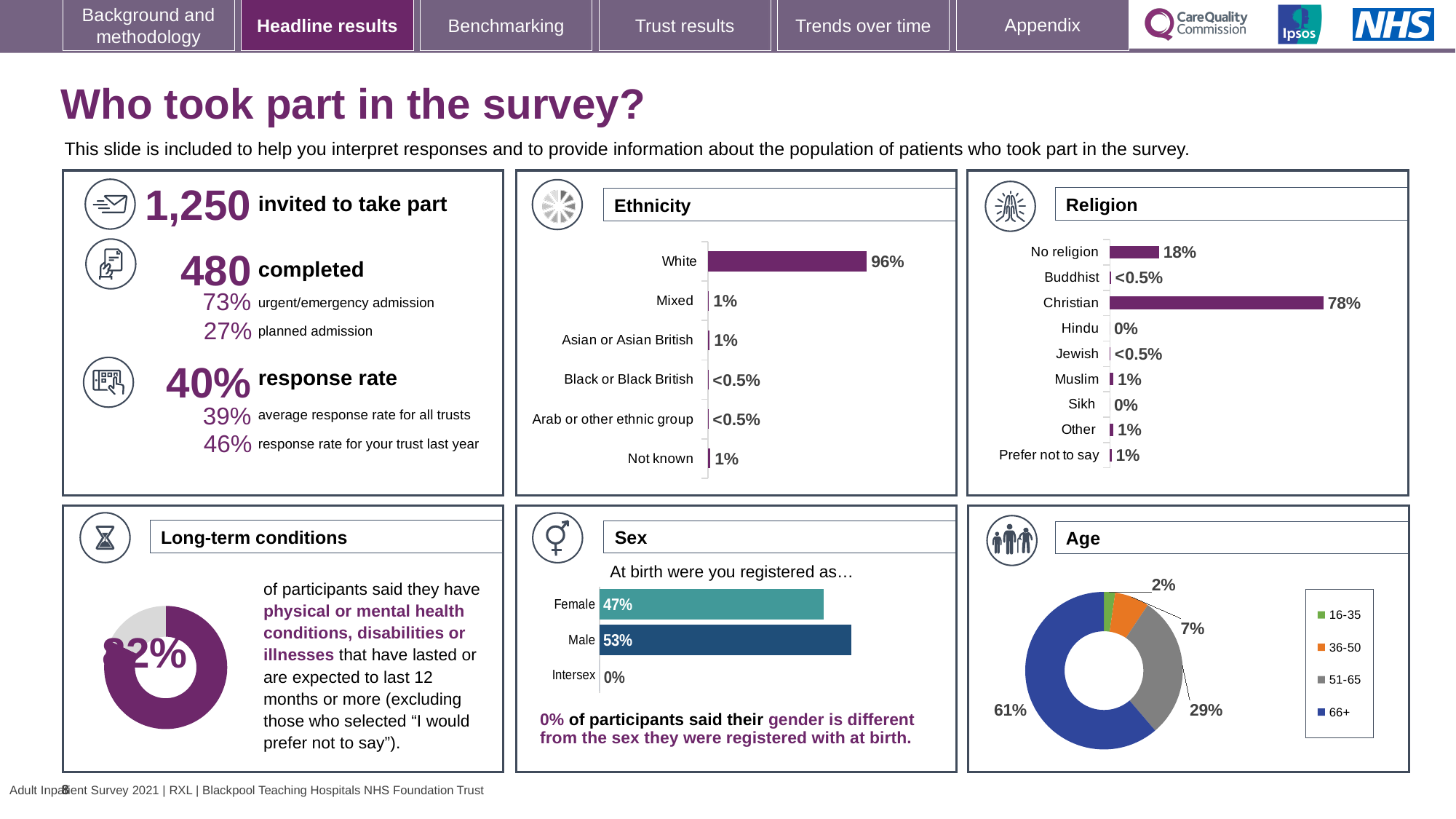
How many ethnic group categories are shown in the Ethnicity chart? 6 In the Sex chart, which is larger, the Female or the Male percentage? Male In the Religion chart, what percentage of participants were Christian? 78% In the Religion chart, what is the difference between the Christian and No religion percentages? 60% In the Ethnicity chart, what percentage of participants were White? 96% How many age groups does the legend of the Age chart list? 4 In the Sex chart, what percentage of participants were registered as Male at birth? 53% In the Age chart, what share of participants were aged 66+? 61% In the Religion chart, what percentage of participants had no religion? 18% In the Ethnicity chart, which ethnic group has the highest percentage? White What kind of chart is used in the Age panel? Doughnut (pie) chart How many religion categories are listed in the Religion chart? 9